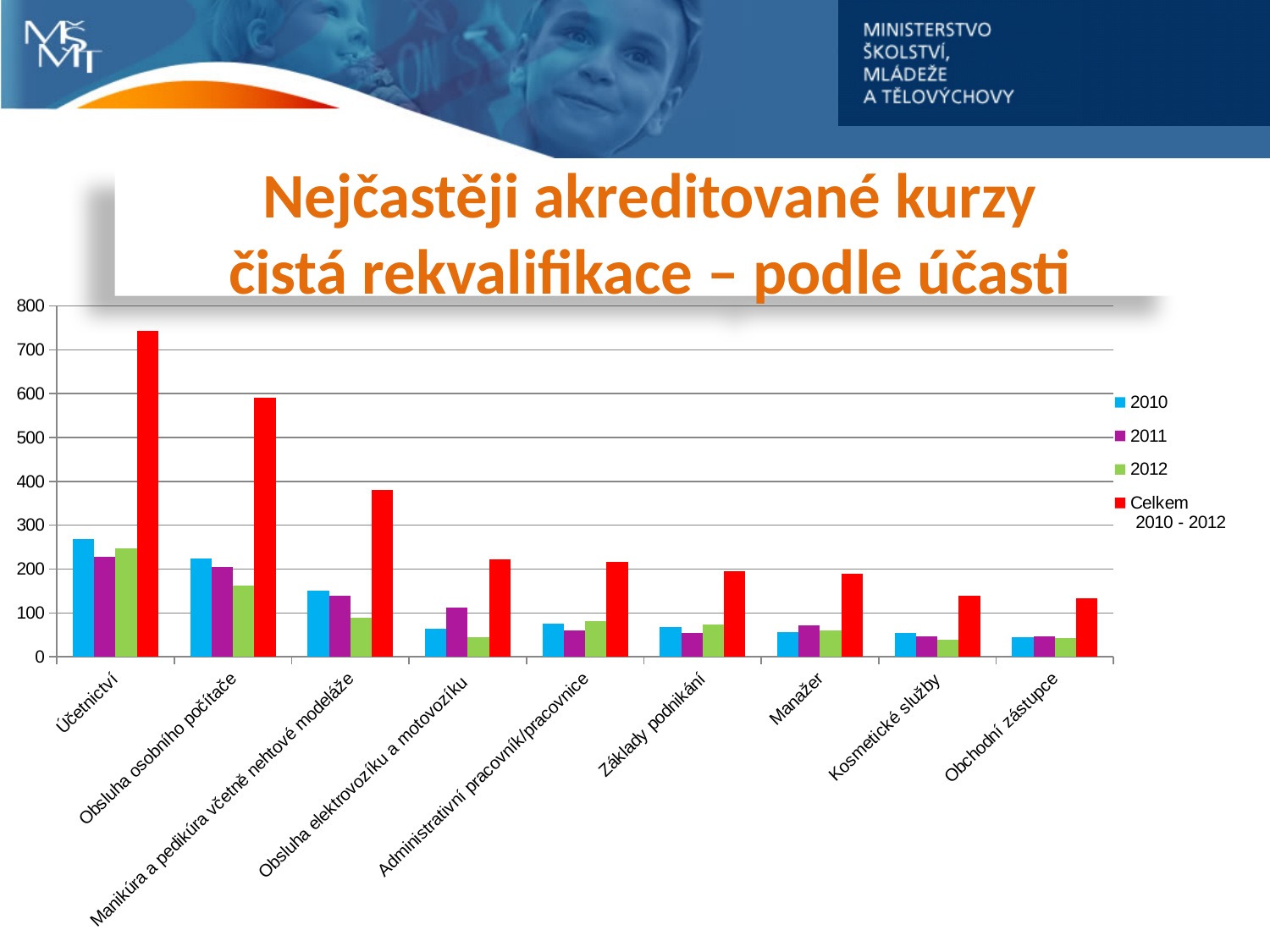
What kind of chart is shown on the slide? bar chart How many course categories are shown on the x axis? 9 How many series does the legend list? 4 Which category has the highest value for Celkem 2010 - 2012? Účetnictví Do the Celkem 2010 - 2012 values rise or fall from left to right along the x axis? fall Is the Celkem 2010 - 2012 value for Účetnictví greater or less than 700? greater Is the Celkem 2010 - 2012 value for Manikúra a pedikúra včetně nehtové modeláže greater or less than 300? greater Is the Celkem 2010 - 2012 value for Obsluha osobního počítače greater or less than 500? greater For Obsluha osobního počítače, which is larger: the 2010 value or the 2012 value? 2010 What colour represents the Celkem 2010 - 2012 series? red For Obsluha elektrovozíku a motovozíku, which is larger: the 2011 value or the 2012 value? 2011